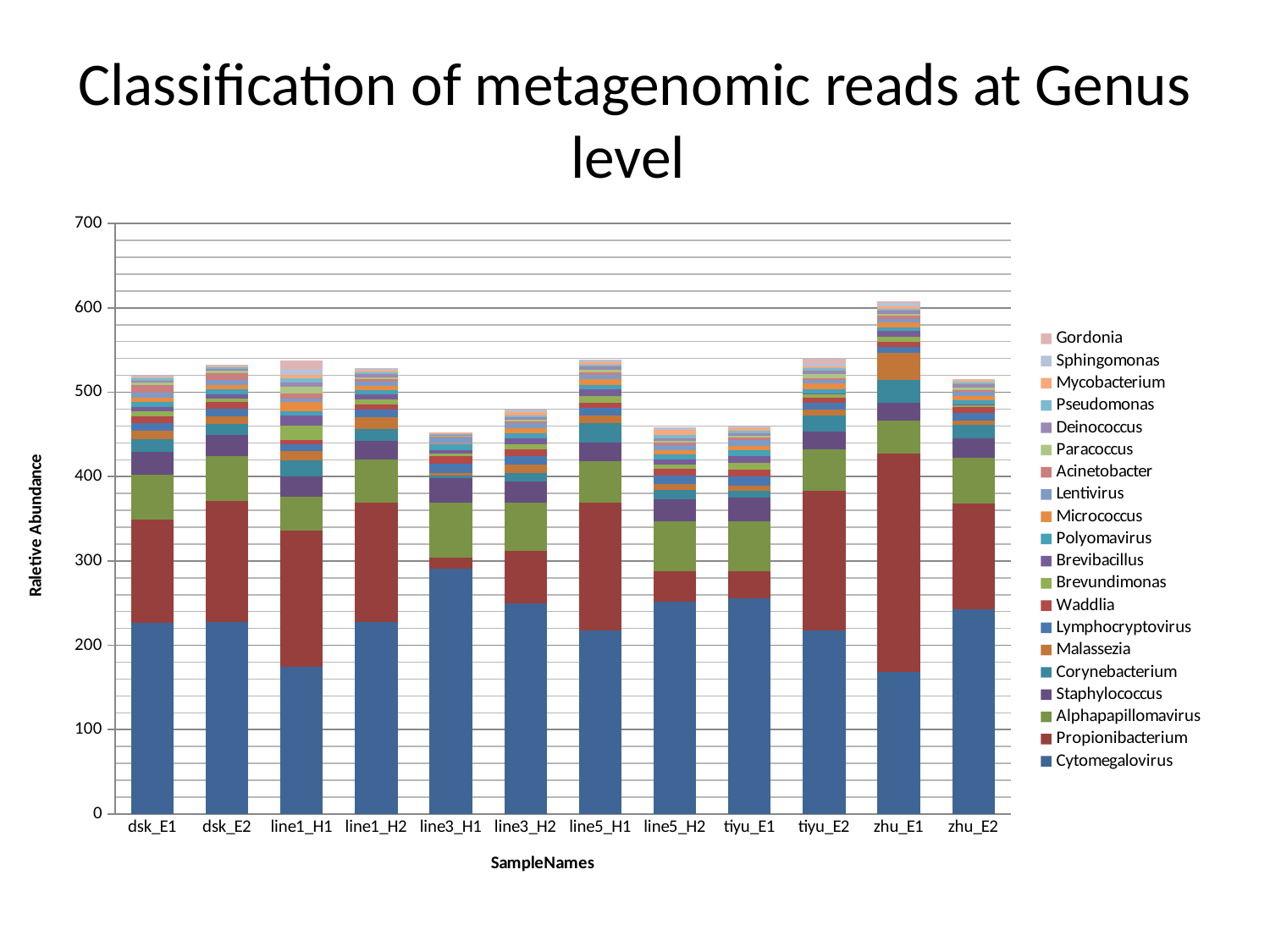
What is the title of the chart? Classification of metagenomic reads at Genus level How many series does the legend list? 20 Which sample has the tallest stacked bar overall? zhu_E1 Is the Cytomegalovirus value for line3_H1 greater or less than 200? greater Is the total stacked value for line3_H1 greater or less than 500? less What kind of chart is shown on the slide? Stacked bar chart What is the label on the x axis? SampleNames Which sample has the largest Cytomegalovirus segment? line3_H1 How many sample categories are shown on the x axis? 12 Which has the larger total stacked bar, zhu_E1 or line3_H1? zhu_E1 Is the Cytomegalovirus value for zhu_E1 greater or less than 200? less